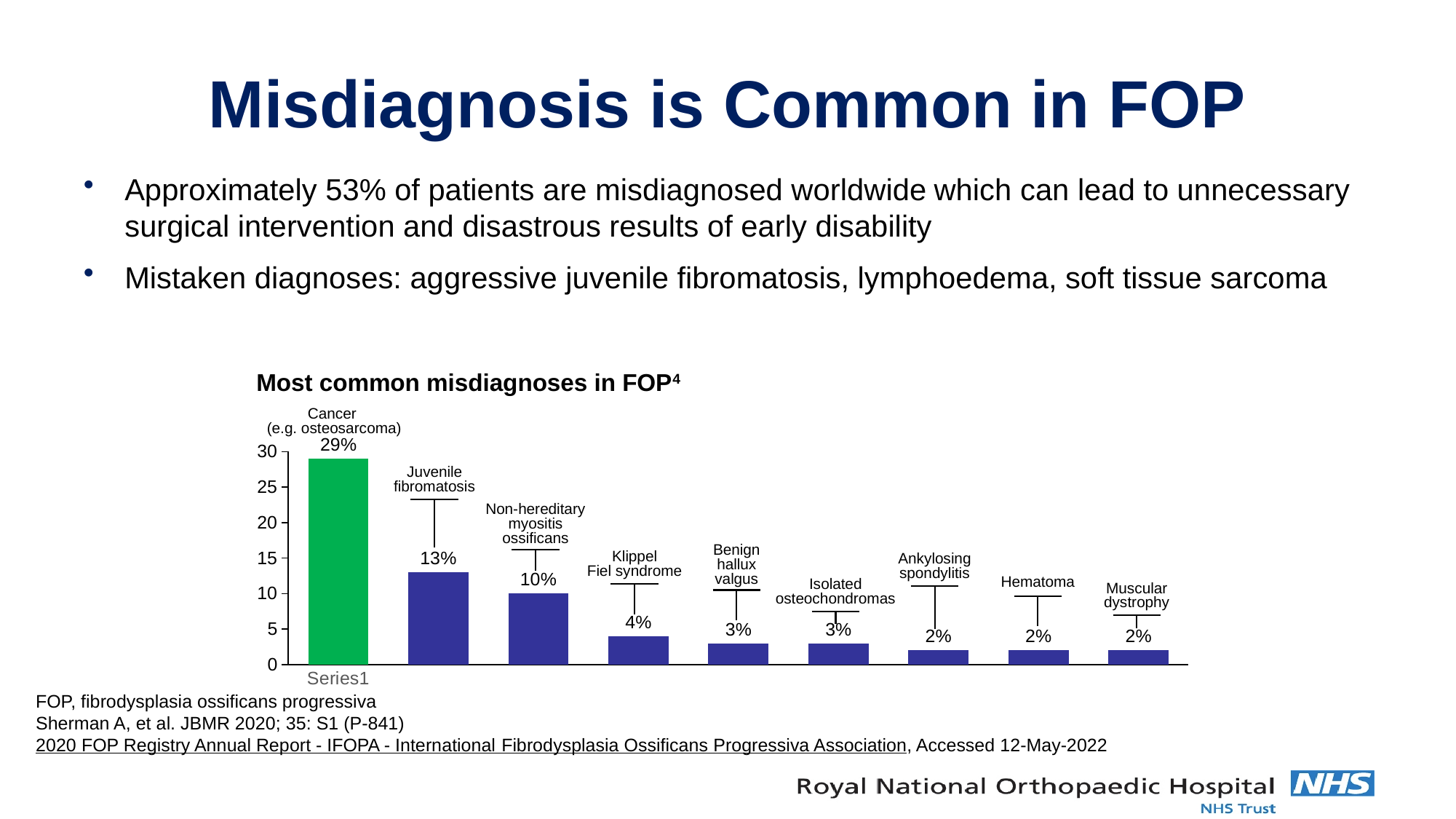
What percentage is shown for Cancer (e.g. osteosarcoma) in the misdiagnoses chart? 29% How many misdiagnosis categories (bars) are plotted in the chart? 9 What is the difference in percentage points between Cancer (e.g. osteosarcoma) and Juvenile fibromatosis? 16 Which is larger, the value for Non-hereditary myositis ossificans or the value for Klippel Fiel syndrome? Non-hereditary myositis ossificans What kind of chart is shown under the title "Most common misdiagnoses in FOP"? Bar chart What percentage is shown for Hematoma? 2% What percentage is shown for Juvenile fibromatosis? 13% What percentage is shown for Non-hereditary myositis ossificans? 10% Do the bar values rise or fall from left to right across the chart? Fall What percentage is shown for Klippel Fiel syndrome? 4% Which bar in the chart is coloured green rather than blue? Cancer (e.g. osteosarcoma) Which misdiagnosis has the highest percentage in the chart? Cancer (e.g. osteosarcoma)